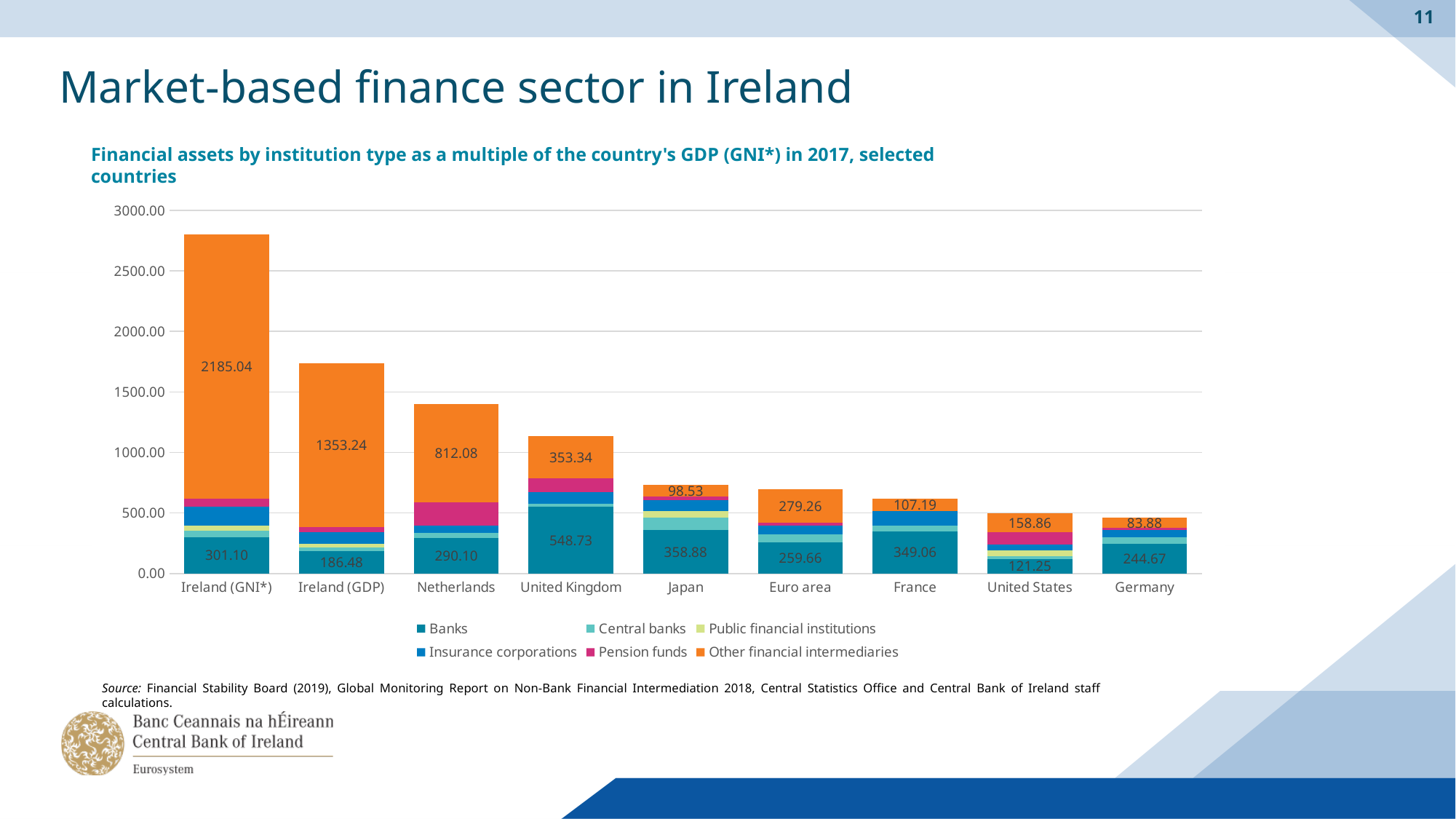
How many countries or regions are shown on the x axis? 9 What is the value for Other financial intermediaries for Germany? 83.88 What kind of chart is shown on the slide? Stacked bar chart How many series does the legend list? 6 What is the value for Other financial intermediaries for the Netherlands? 812.08 Which country has the highest value for Other financial intermediaries? Ireland (GNI*) What is the difference between the Other financial intermediaries values for Ireland (GNI*) and Ireland (GDP)? 831.80 Which is larger, the Other financial intermediaries value for the Euro area or for the United States? Euro area What is the value for Banks for the United Kingdom? 548.73 Which country has the lowest value for Banks? United States Is the total stacked value for the Netherlands greater or less than 1000.00? greater What is the value for Banks for Ireland (GNI*)? 301.10